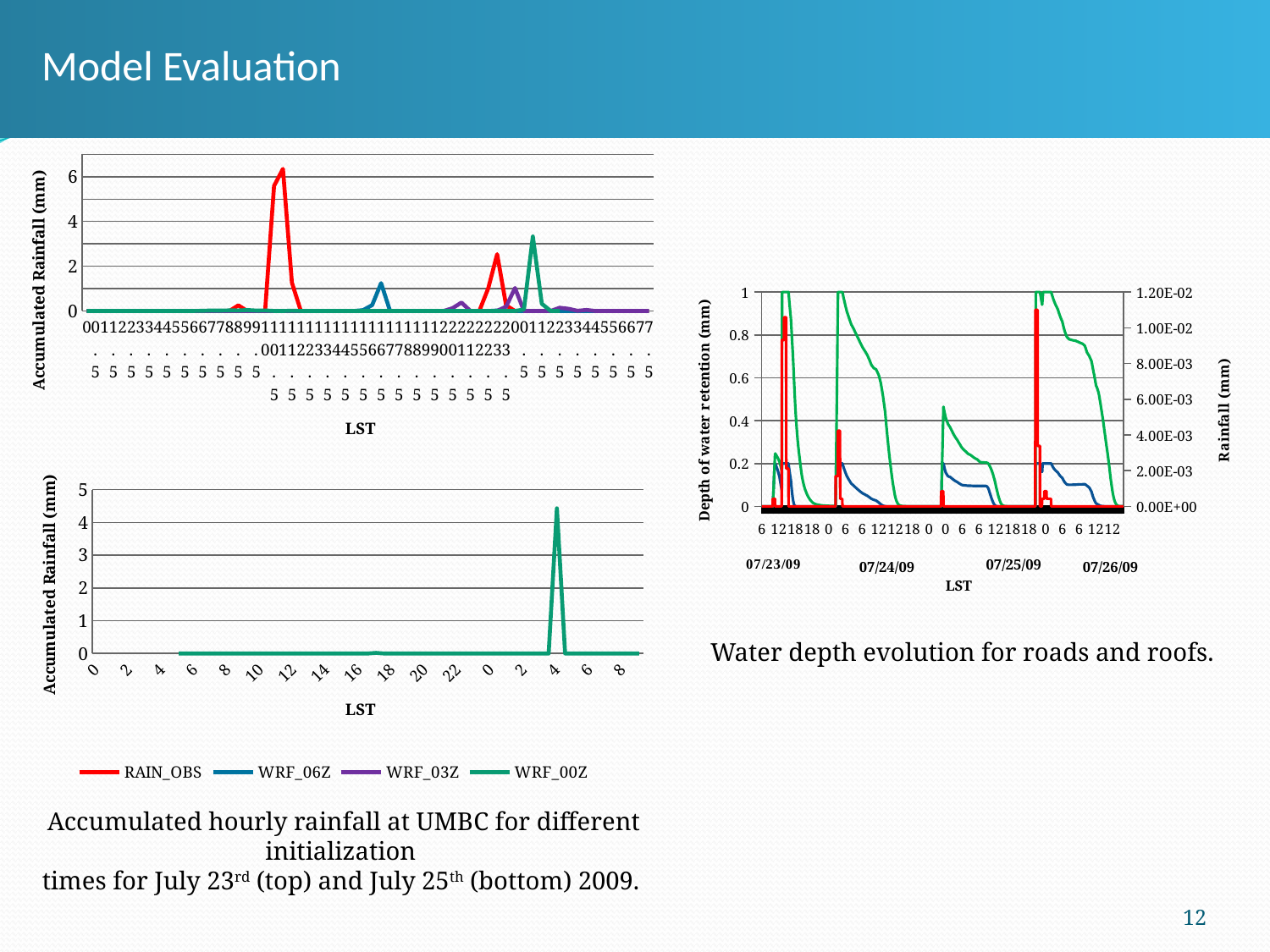
In the top-left chart (July 23rd), which series reaches the highest peak? RAIN_OBS How many series does the legend below the left-hand charts list? 4 In the bottom-left chart (July 25th), at which LST hour does the WRF_00Z peak occur? 4 In the top-left chart (July 23rd), is the peak value of WRF_00Z greater or less than 4? less In the right-hand chart (water depth evolution), how many dates are labelled along the x axis? 4 What are the series names listed in the legend below the left-hand charts? RAIN_OBS, WRF_06Z, WRF_03Z, WRF_00Z What is the x-axis title of the bottom-left chart? LST What kind of chart is the top-left chart on the slide? line chart In the right-hand chart (water depth evolution), is the peak of the blue line greater or less than 0.4 on the left axis? less In the bottom-left chart (July 25th), is the peak value of WRF_00Z greater or less than 4? greater In the top-left chart (July 23rd), which has the higher peak, RAIN_OBS or WRF_06Z? RAIN_OBS